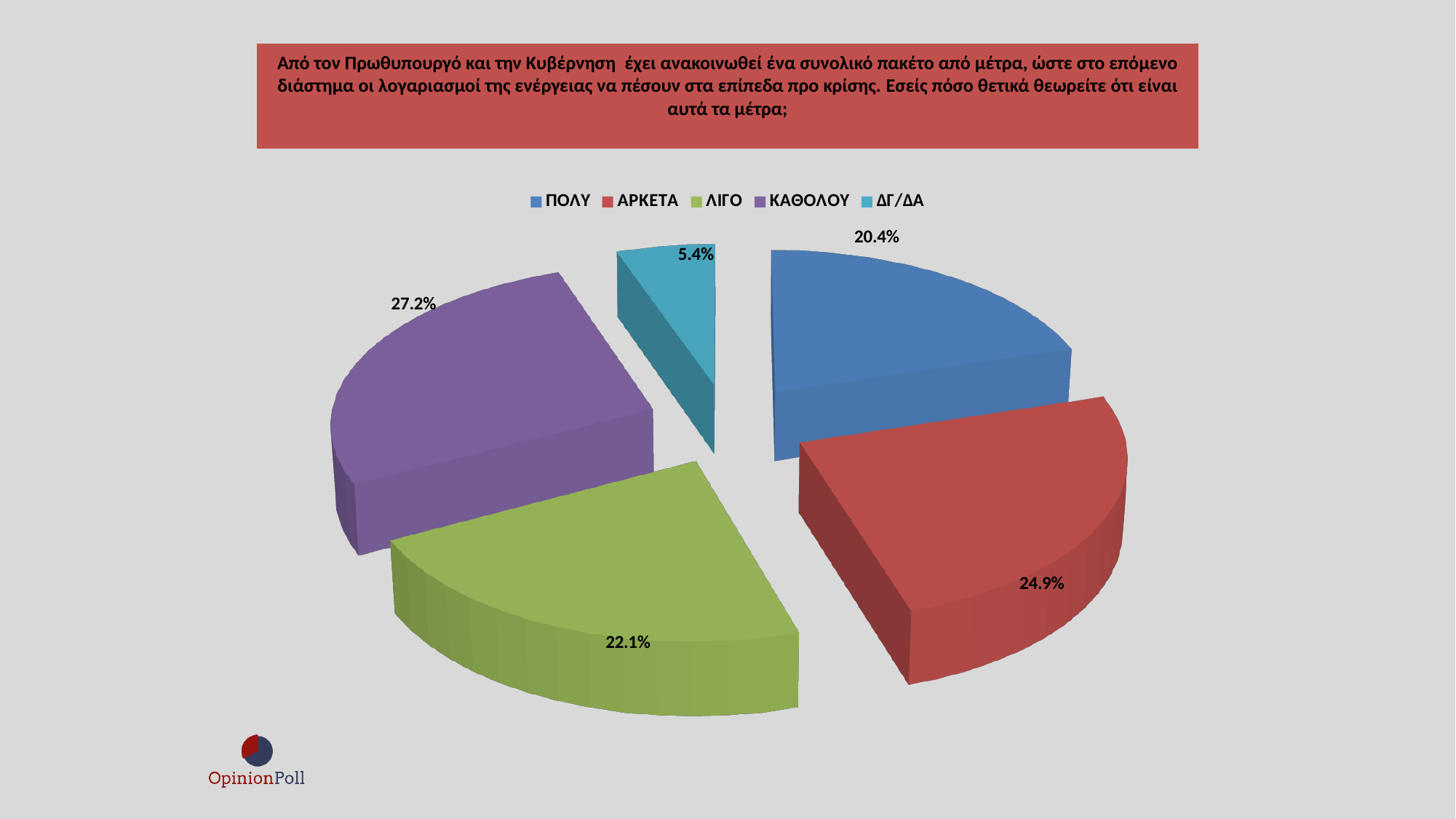
What percentage of respondents answered ΛΙΓΟ? 22.1% Which response has the largest share of the pie? ΚΑΘΟΛΟΥ How many slices does the pie chart have? 5 What colour is the slice for ΛΙΓΟ? Green What percentage of respondents answered ΑΡΚΕΤΑ? 24.9% Which response has the smallest share of the pie? ΔΓ/ΔΑ Which is larger, the share for ΑΡΚΕΤΑ or the share for ΛΙΓΟ? ΑΡΚΕΤΑ What percentage of respondents answered ΔΓ/ΔΑ? 5.4% What percentage of respondents answered ΚΑΘΟΛΟΥ? 27.2% What type of chart is shown on the slide? Pie chart What percentage of respondents answered ΠΟΛΥ? 20.4% What is the difference in percentage points between ΚΑΘΟΛΟΥ and ΠΟΛΥ? 6.8